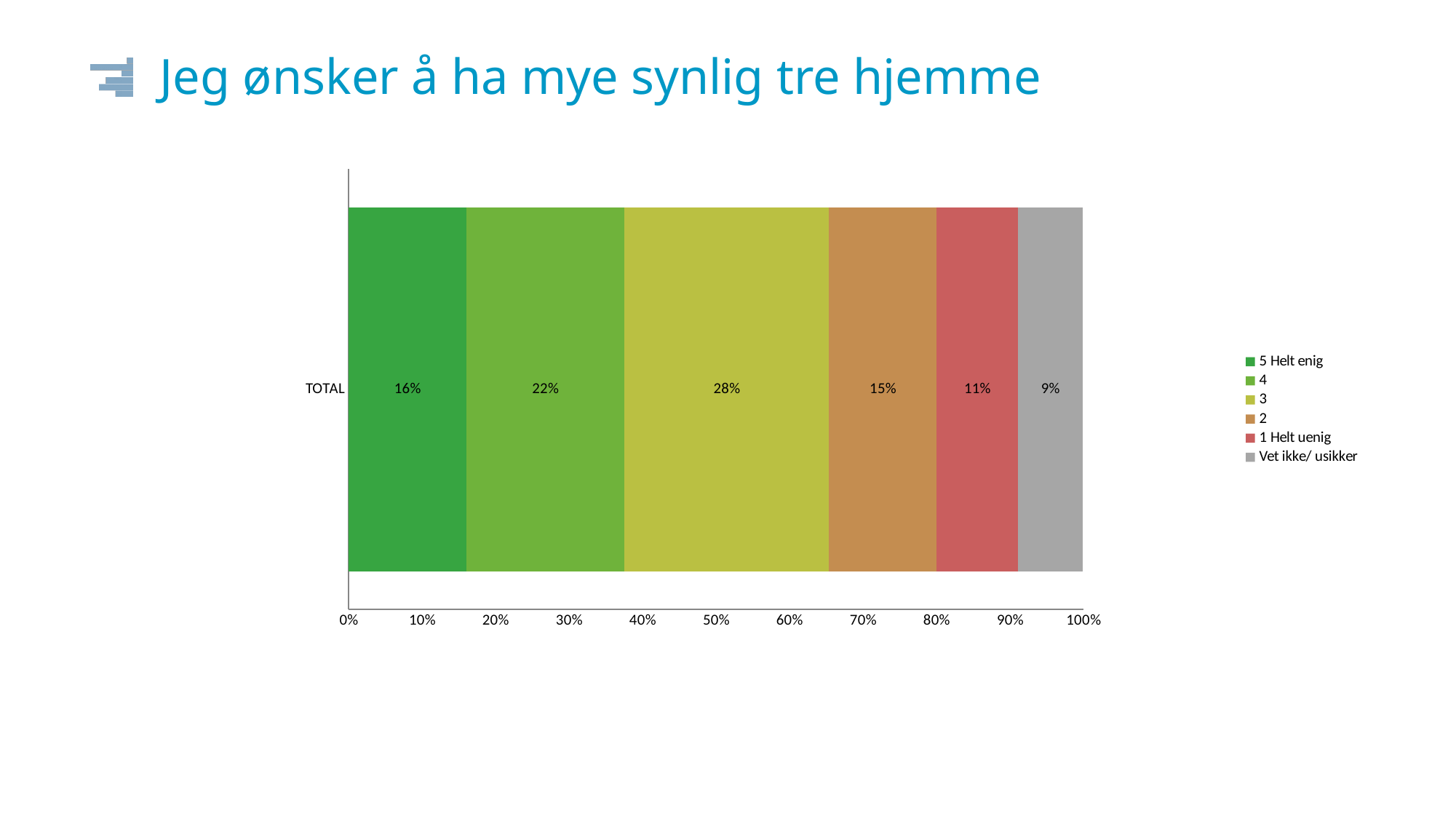
What is the difference between the "4" segment and the "2" segment in the TOTAL bar? 7% What share of the TOTAL bar is "Vet ikke/ usikker"? 9% How many series does the legend list? 6 What is the combined share of "5 Helt enig" and "4" in the TOTAL bar? 38% What is the value for the "3" segment of the TOTAL bar? 28% Which is larger in the TOTAL bar: "5 Helt enig" or "1 Helt uenig"? 5 Helt enig What is the title of the slide? Jeg ønsker å ha mye synlig tre hjemme Which response category has the smallest share of the TOTAL bar? Vet ikke/ usikker What kind of chart is shown on the slide? Stacked bar chart What percentage of respondents answered "5 Helt enig" for TOTAL? 16% What is the value for "1 Helt uenig" in the TOTAL bar? 11% Which response category has the largest share of the TOTAL bar? 3